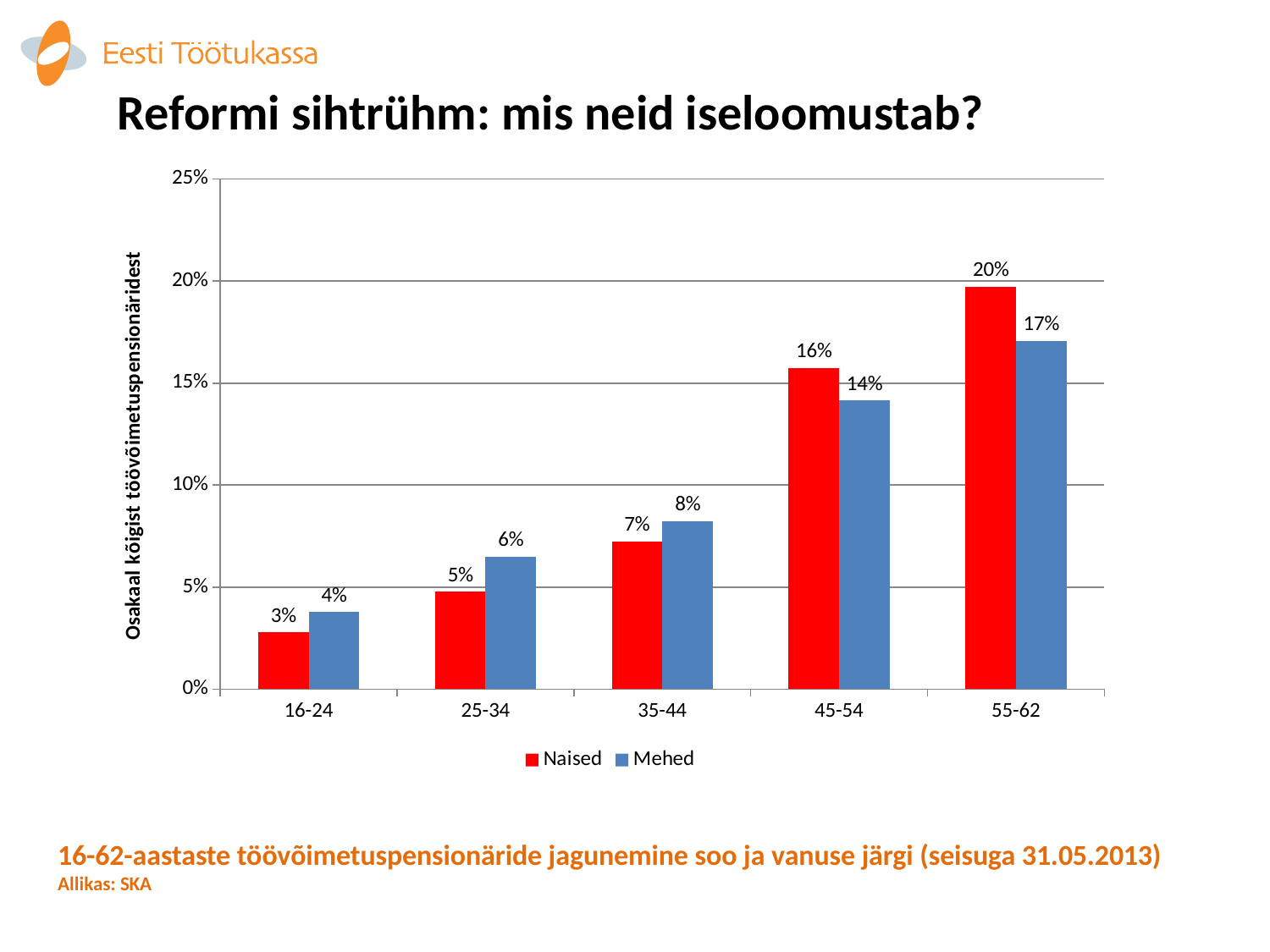
What is the difference between the Naised and Mehed values in the 55-62 age group? 3% What is the value for Naised in the 16-24 age group? 3% In the 25-34 age group, which is larger, Naised or Mehed? Mehed Which age group has the lowest value for Naised? 16-24 What is the value for Mehed in the 35-44 age group? 8% How many age groups are shown on the x axis? 5 Is the value for Naised in the 45-54 age group greater or less than 15%? greater What kind of chart is shown on the slide? bar chart Which age group has the highest value for Mehed? 55-62 How many series does the legend list? 2 What is the value for Naised in the 55-62 age group? 20% Do the Naised values rise or fall as the age groups increase along the x axis? rise